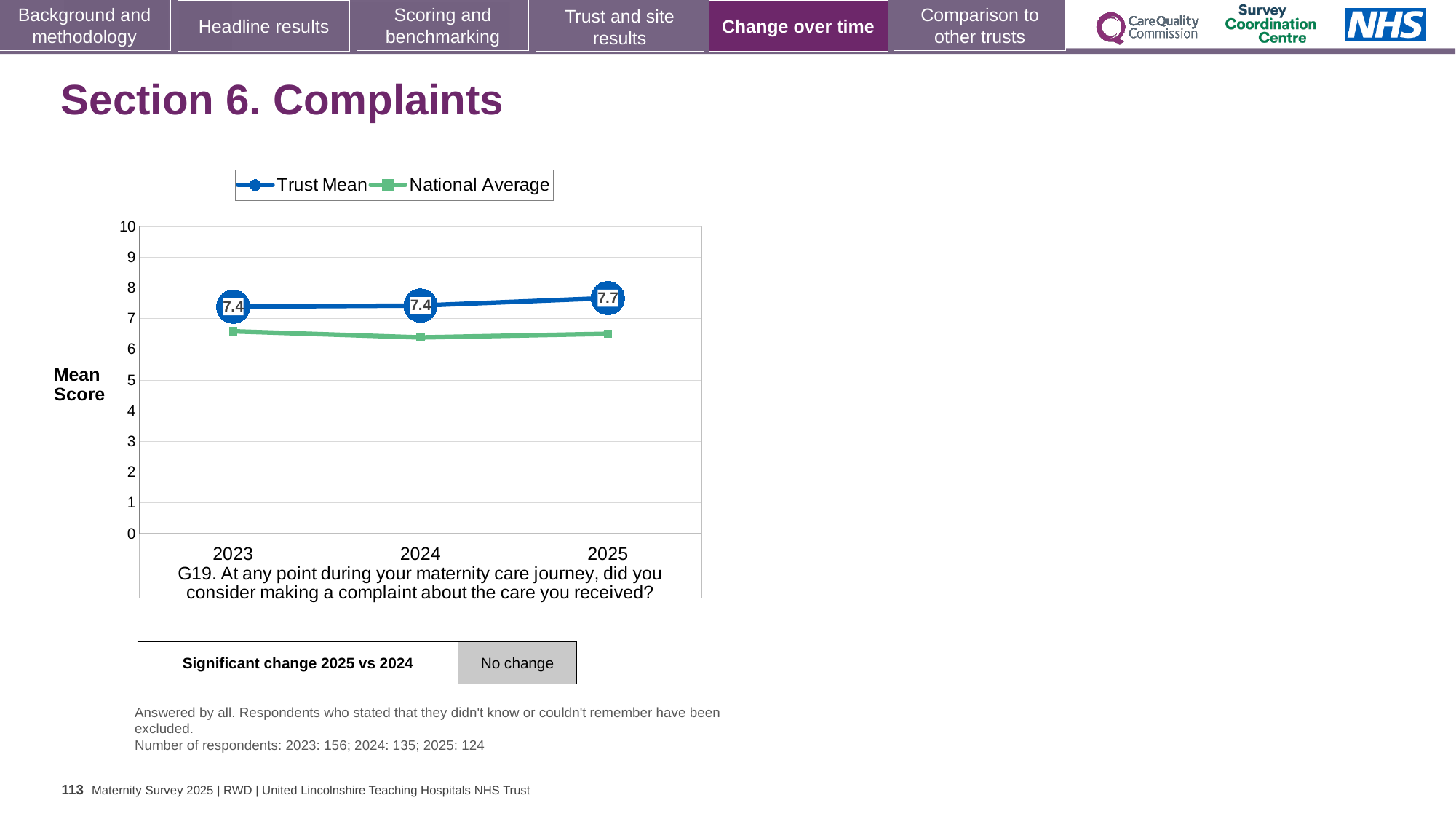
In which year is the Trust Mean highest? 2025 What kind of chart is shown? line chart What is the Trust Mean score for 2023? 7.4 What is the label on the y axis? Mean Score Is the National Average for 2024 greater or less than 7? less What is the difference between the Trust Mean in 2025 and in 2024? 0.3 In 2025, which is larger: the Trust Mean or the National Average? Trust Mean Is the National Average for 2023 greater or less than 6? greater What is the Trust Mean score for 2024? 7.4 How many years are shown on the x axis? 3 What is the Trust Mean score for 2025? 7.7 How many series does the legend list? 2